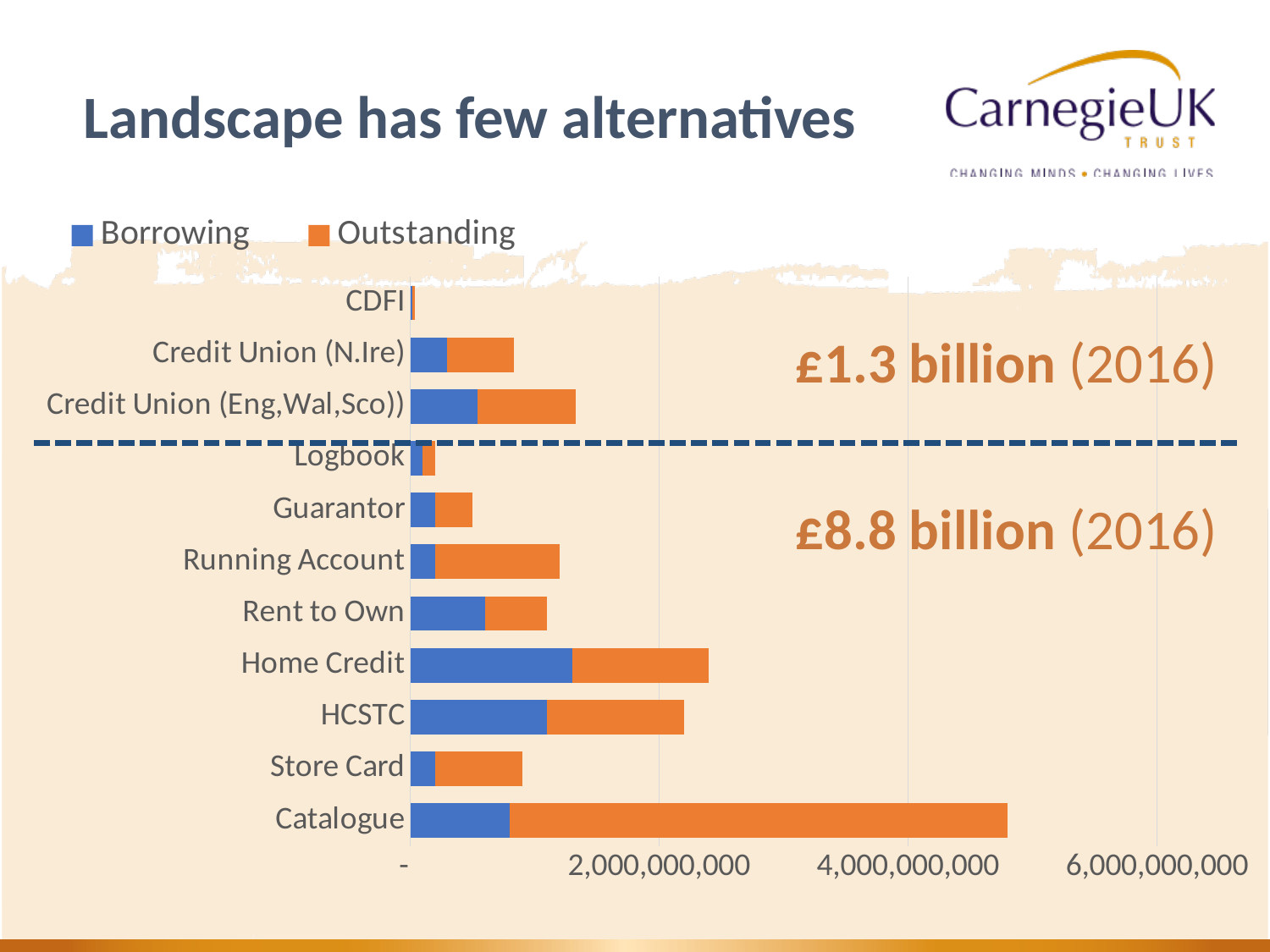
Which category has the longest total bar? Catalogue How many series does the legend list? 2 How many categories are plotted on the chart? 11 Which category has the shortest total bar? CDFI Is the Borrowing value for Catalogue greater or less than 2,000,000,000? less Which has the larger total bar, Home Credit or Store Card? Home Credit Which has the larger Borrowing value, Home Credit or Catalogue? Home Credit Is the total bar for Catalogue greater or less than 4,000,000,000? greater What kind of chart is shown on the slide? Bar chart What colour represents the Outstanding series? Orange Is the total bar for Home Credit greater or less than 4,000,000,000? less What are the two series named in the legend? Borrowing and Outstanding